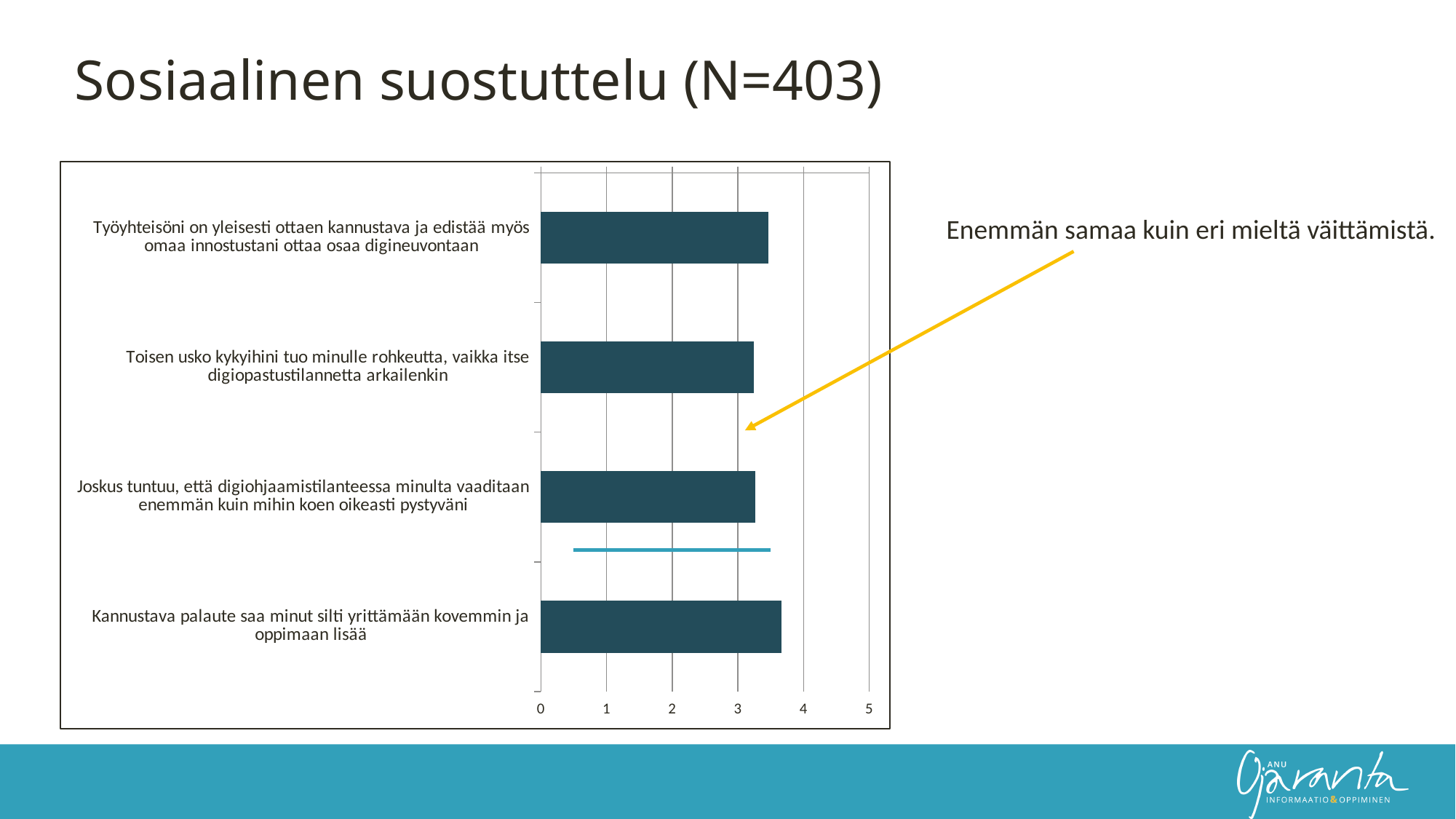
Which has the larger value: "Kannustava palaute saa minut silti yrittämään kovemmin ja oppimaan lisää" or "Toisen usko kykyihini tuo minulle rohkeutta, vaikka itse digiopastustilannetta arkailenkin"? Kannustava palaute saa minut silti yrittämään kovemmin ja oppimaan lisää Which statement has the highest value in the chart? Kannustava palaute saa minut silti yrittämään kovemmin ja oppimaan lisää What kind of chart is shown on the slide? bar chart Is the value for "Työyhteisöni on yleisesti ottaen kannustava ja edistää myös omaa innostustani ottaa osaa digineuvontaan" greater or less than 3? greater Is the value for "Kannustava palaute saa minut silti yrittämään kovemmin ja oppimaan lisää" greater or less than 4? less What is the title of the slide containing the chart? Sosiaalinen suostuttelu (N=403) What is the maximum value shown on the chart's horizontal axis? 5 Is the value for "Joskus tuntuu, että digiohjaamistilanteessa minulta vaaditaan enemmän kuin mihin koen oikeasti pystyväni" greater or less than 3? greater How many categories (statements) are plotted in the chart? 4 Which has the larger value: "Työyhteisöni on yleisesti ottaen kannustava ja edistää myös omaa innostustani ottaa osaa digineuvontaan" or "Toisen usko kykyihini tuo minulle rohkeutta, vaikka itse digiopastustilannetta arkailenkin"? Työyhteisöni on yleisesti ottaen kannustava ja edistää myös omaa innostustani ottaa osaa digineuvontaan